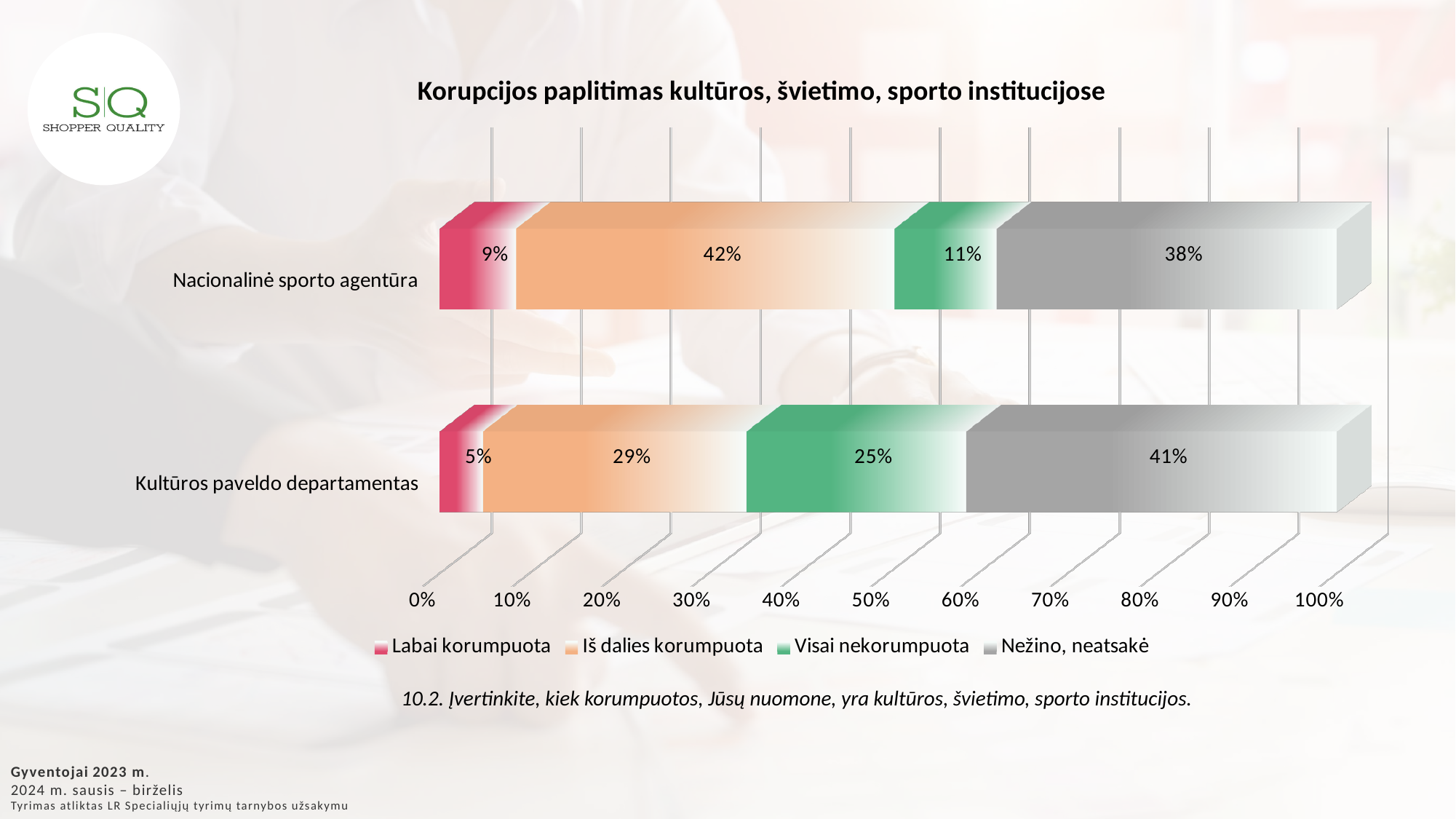
How many categories are shown on the chart? 2 Which category has the lower value for "Labai korumpuota"? Kultūros paveldo departamentas What is the value for "Nežino, neatsakė" for Kultūros paveldo departamentas? 41% What is the title of the chart? Korupcijos paplitimas kultūros, švietimo, sporto institucijose What is the difference between the "Iš dalies korumpuota" values for Nacionalinė sporto agentūra and Kultūros paveldo departamentas? 13 percentage points How many series does the legend list? 4 Is the "Nežino, neatsakė" value larger for Nacionalinė sporto agentūra or for Kultūros paveldo departamentas? Kultūros paveldo departamentas What is the value for "Visai nekorumpuota" for Nacionalinė sporto agentūra? 11% What is the value for "Labai korumpuota" for Kultūros paveldo departamentas? 5% What kind of chart is shown on the slide? Stacked bar chart What is the value for "Iš dalies korumpuota" for Nacionalinė sporto agentūra? 42% Which category has the higher value for "Visai nekorumpuota"? Kultūros paveldo departamentas